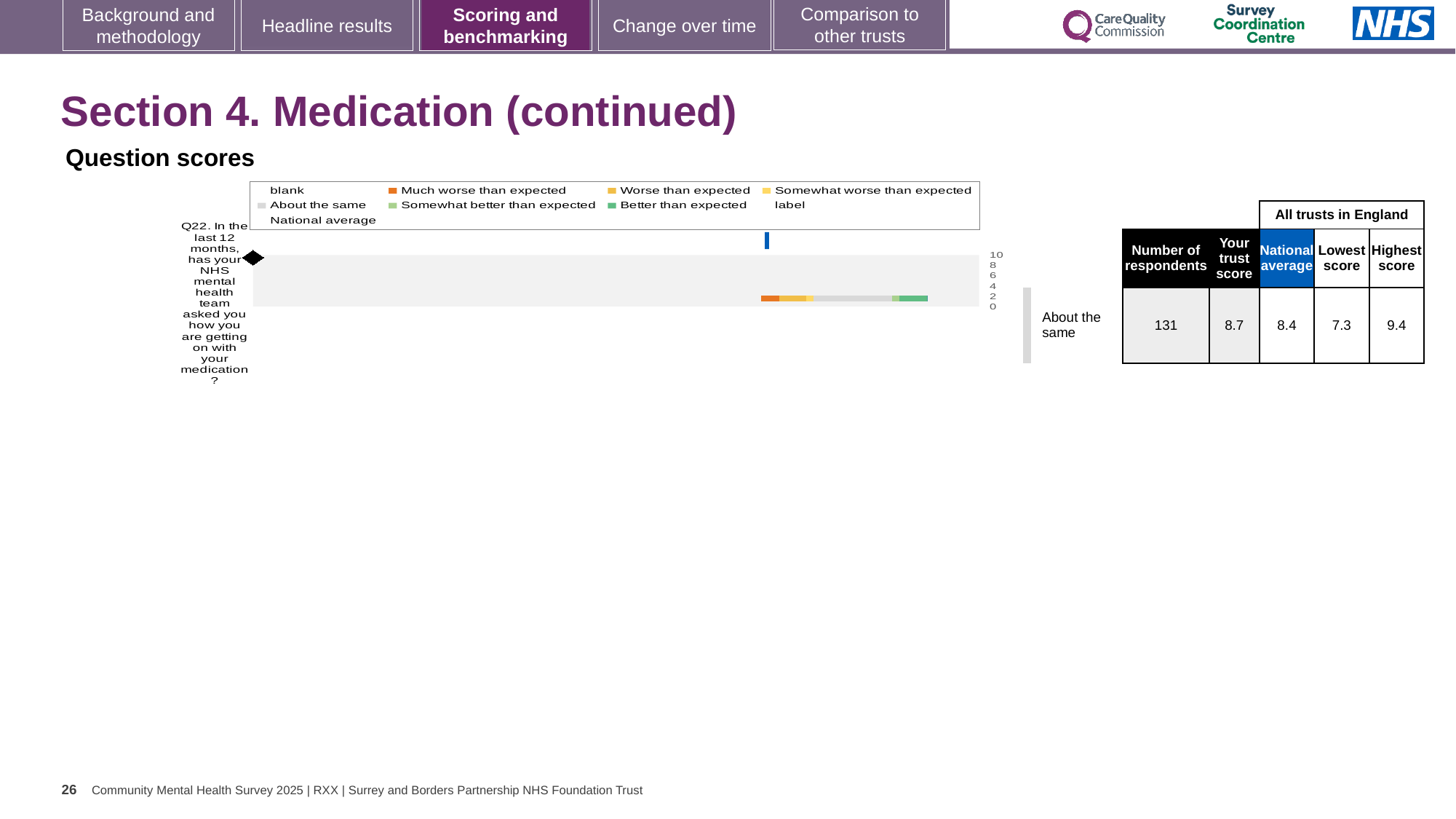
What benchmark category is shown for Q22? About the same What is the lowest score among all trusts in England for Q22? 7.3 What is the national average score for Q22? 8.4 Which question is plotted in the chart? Q22. In the last 12 months, has your NHS mental health team asked you how you are getting on with your medication? What is the highest score among all trusts in England for Q22? 9.4 What is the number of respondents for Q22? 131 What kind of chart is shown on the slide? bar chart How many questions are plotted in the chart? 1 What is the difference between the trust's score and the national average for Q22? 0.3 What is the difference between the highest and lowest scores among all trusts in England for Q22? 2.1 Which is larger for Q22, the trust's score or the national average? the trust's score What is the trust's score for Q22? 8.7